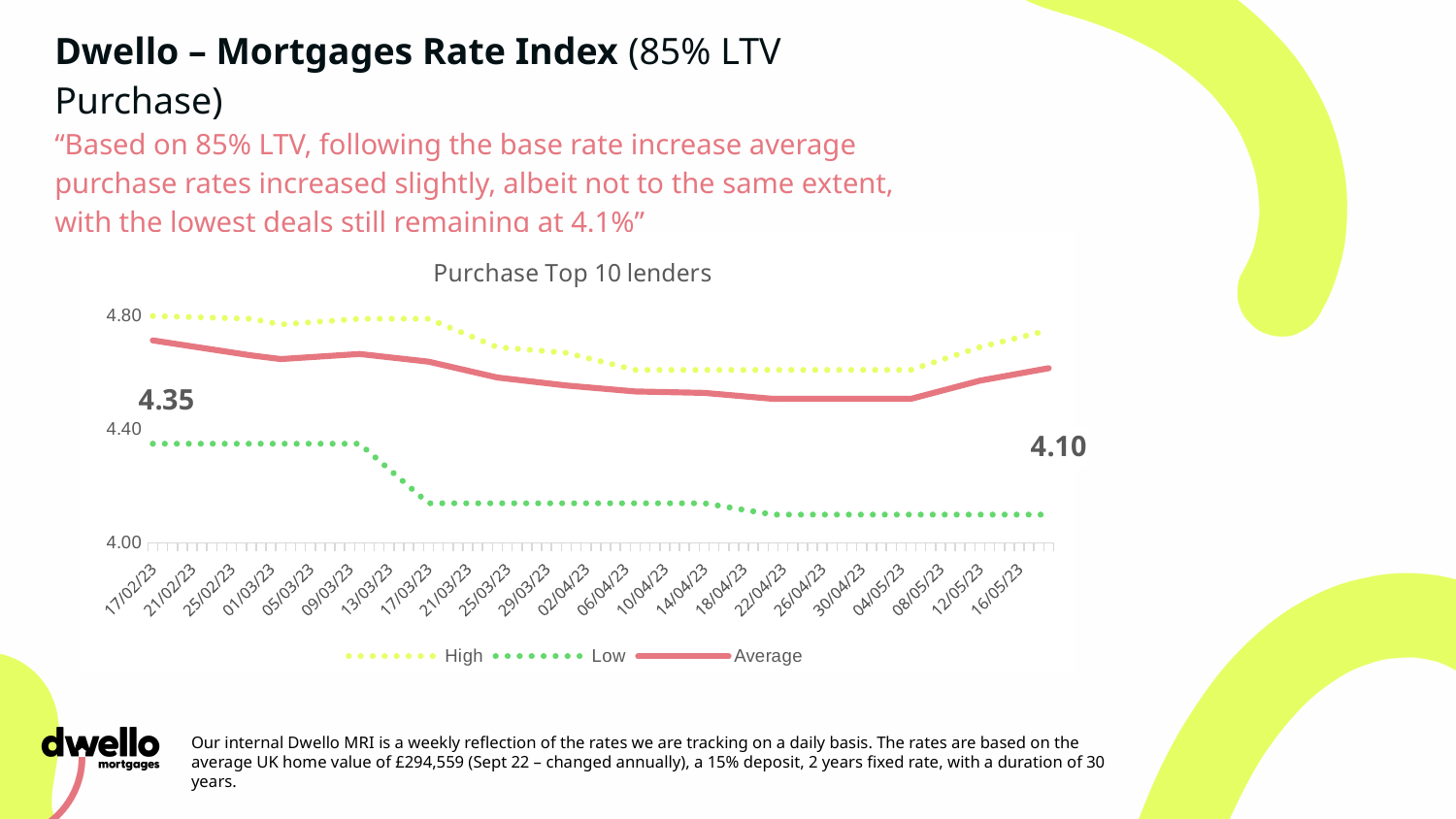
How many series does the legend of the "Purchase Top 10 lenders" chart list? 3 What is the value of the Low series on 16/05/23? 4.10 Which is larger for the Low series: the value on 17/02/23 or the value on 16/05/23? 17/02/23 What are the three series named in the legend of the chart? High, Low, Average By how much did the Low series fall between 17/02/23 and 16/05/23? 0.25 Is the value of the Low series on 16/05/23 greater or less than 4.40? less What is the value of the Low series on 17/02/23? 4.35 What kind of chart is shown under the title "Purchase Top 10 lenders"? Line chart Does the Low series rise or fall from 17/02/23 to 16/05/23? Fall Which series has the highest values across the whole chart? High How many date labels are shown on the x axis of the chart? 23 Is the value of the Average series on 17/02/23 greater or less than 4.40? greater